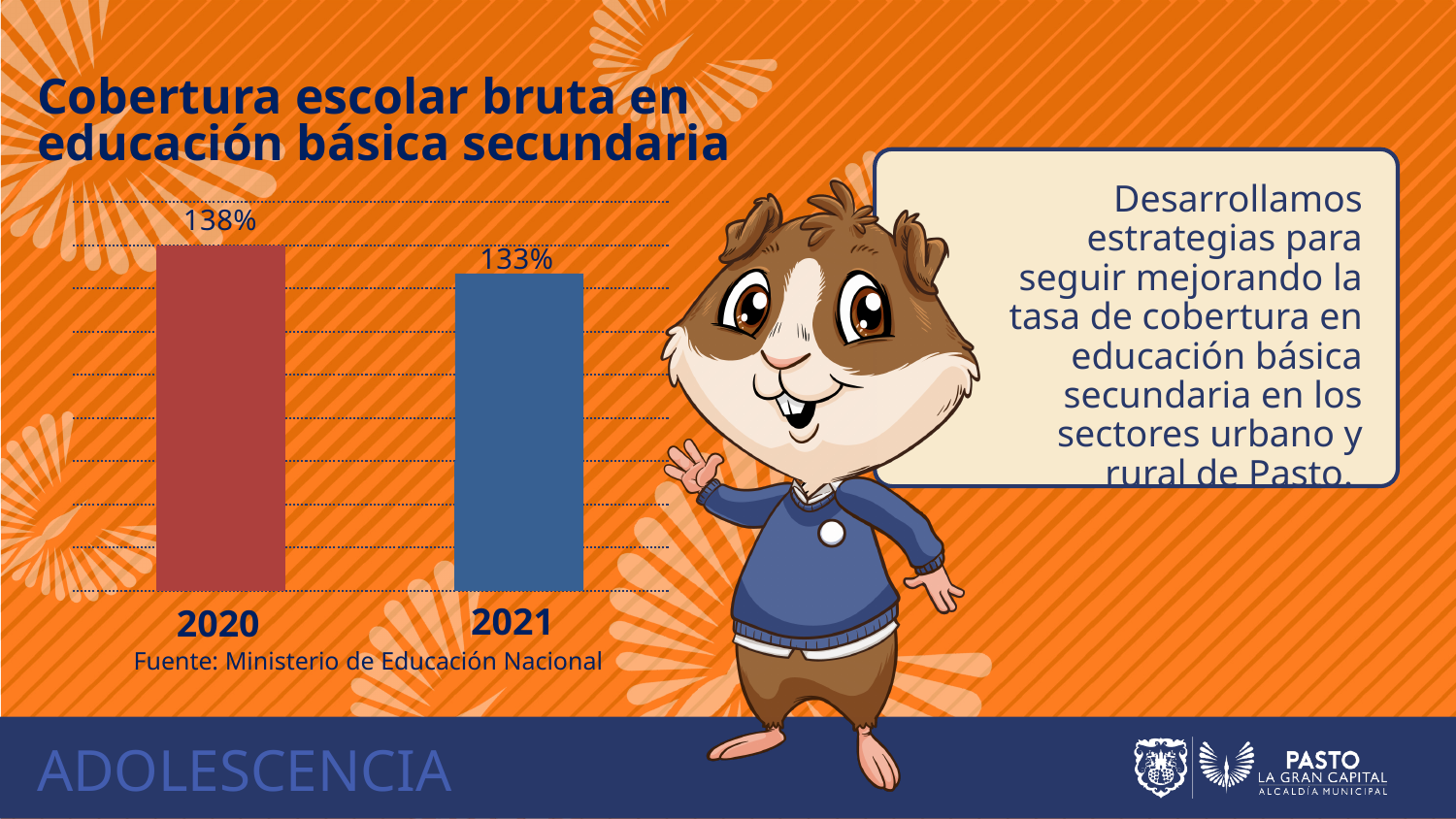
Which year has the lowest value? 2021 Do the values rise or fall from 2020 to 2021? fall Which year has the highest value? 2020 How many bars are shown in the chart? 2 What is the value for 2021? 133% Which is larger, the value for 2020 or the value for 2021? 2020 What is the difference between the values for 2020 and 2021? 5% What colour is the bar for 2020? red What kind of chart is shown on the slide? bar chart What is the value for 2020? 138% What is the title of the chart? Cobertura escolar bruta en educación básica secundaria